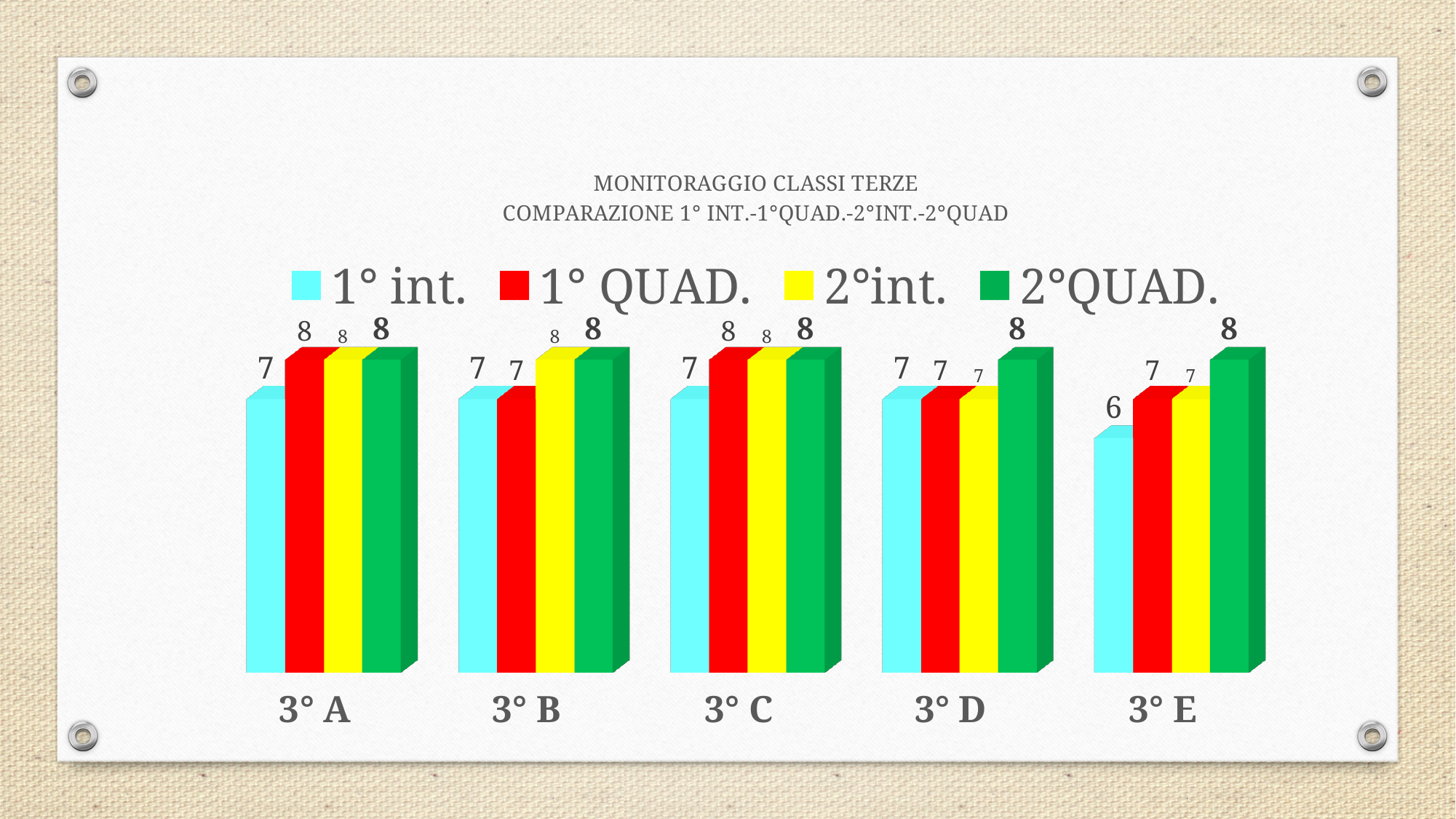
What is the value of 2°int. for 3° D? 7 What is the value of 1° int. for 3° E? 6 How many series does the legend list? 4 What is the value of 1° QUAD. for 3° B? 7 What kind of chart is shown on the slide? Bar chart What is the difference between the 2°QUAD. value and the 1° int. value for 3° E? 2 Do the values for 3° E rise or fall from 1° int. to 2°QUAD.? Rise Which class has the lowest 1° int. value? 3° E Which colour represents the 2°int. series in the legend? Yellow Which is larger for 3° A: the 1° int. value or the 1° QUAD. value? 1° QUAD. How many classes are shown on the x axis? 5 What is the value of 2°QUAD. for 3° C? 8